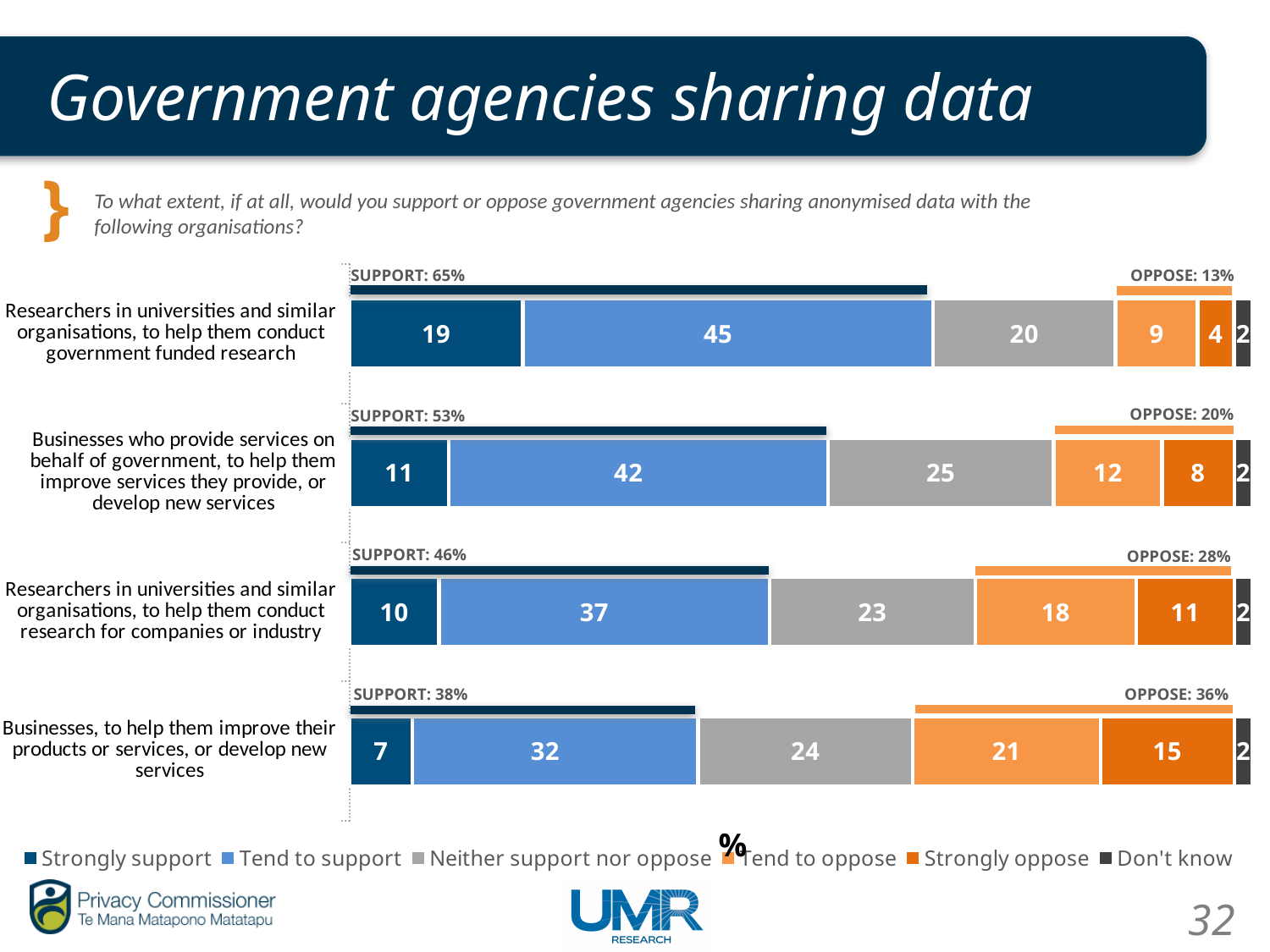
What is the difference between the 'Neither support nor oppose' values for 'Businesses who provide services on behalf of government' and 'Researchers in universities and similar organisations, to help them conduct government funded research'? 5 What is the total of all segments in the bar for 'Businesses who provide services on behalf of government, to help them improve services they provide, or develop new services'? 100 Which category has the lowest 'Tend to oppose' value? Researchers in universities and similar organisations, to help them conduct government funded research What is the total SUPPORT percentage shown for 'Researchers in universities and similar organisations, to help them conduct research for companies or industry'? 46% What is the 'Strongly oppose' value for 'Businesses, to help them improve their products or services, or develop new services'? 15 What is the OPPOSE percentage shown for 'Businesses, to help them improve their products or services, or develop new services'? 36% What is the 'Tend to support' value for 'Businesses who provide services on behalf of government, to help them improve services they provide, or develop new services'? 42 Which is larger: the 'Tend to oppose' value for 'Businesses, to help them improve their products or services, or develop new services' or the 'Tend to oppose' value for 'Researchers in universities and similar organisations, to help them conduct research for companies or industry'? Businesses, to help them improve their products or services, or develop new services How many organisation categories are plotted in the chart? 4 How many series does the legend list? 6 What type of chart is shown on the slide? Stacked bar chart Which category has the highest 'Strongly support' value? Researchers in universities and similar organisations, to help them conduct government funded research